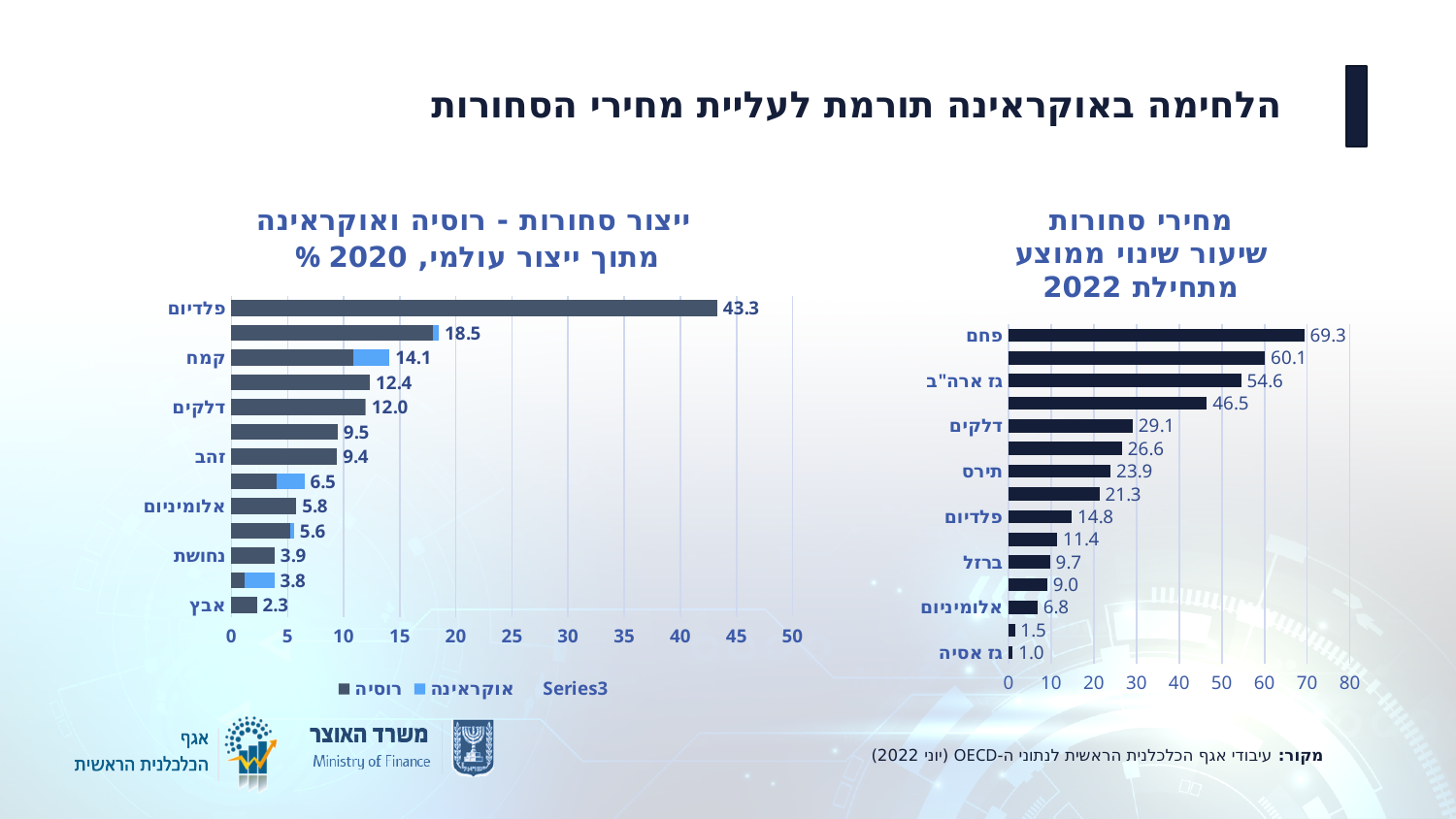
In the right chart (מחירי סחורות), how many bars are plotted? 15 In the left chart (ייצור סחורות - רוסיה ואוקראינה), what is the value for דלקים? 12.0 In the left chart (ייצור סחורות - רוסיה ואוקראינה), which is larger, the value for זהב or the value for אלומיניום? זהב In the right chart (מחירי סחורות), what is the value for פחם? 69.3 How many entries does the legend of the left chart list? 3 In the left chart (ייצור סחורות - רוסיה ואוקראינה), what is the value for פלדיום? 43.3 In the left chart (ייצור סחורות - רוסיה ואוקראינה), what is the difference between the values for פלדיום and קמח? 29.2 What kind of chart is the right chart (מחירי סחורות)? Bar chart In the right chart (מחירי סחורות), what is the difference between the values for פחם and גז ארה"ב? 14.7 In the right chart (מחירי סחורות), which category has the lowest value? גז אסיה In the left chart (ייצור סחורות - רוסיה ואוקראינה), which category has the highest value? פלדיום In the right chart (מחירי סחורות), what is the value for גז ארה"ב? 54.6